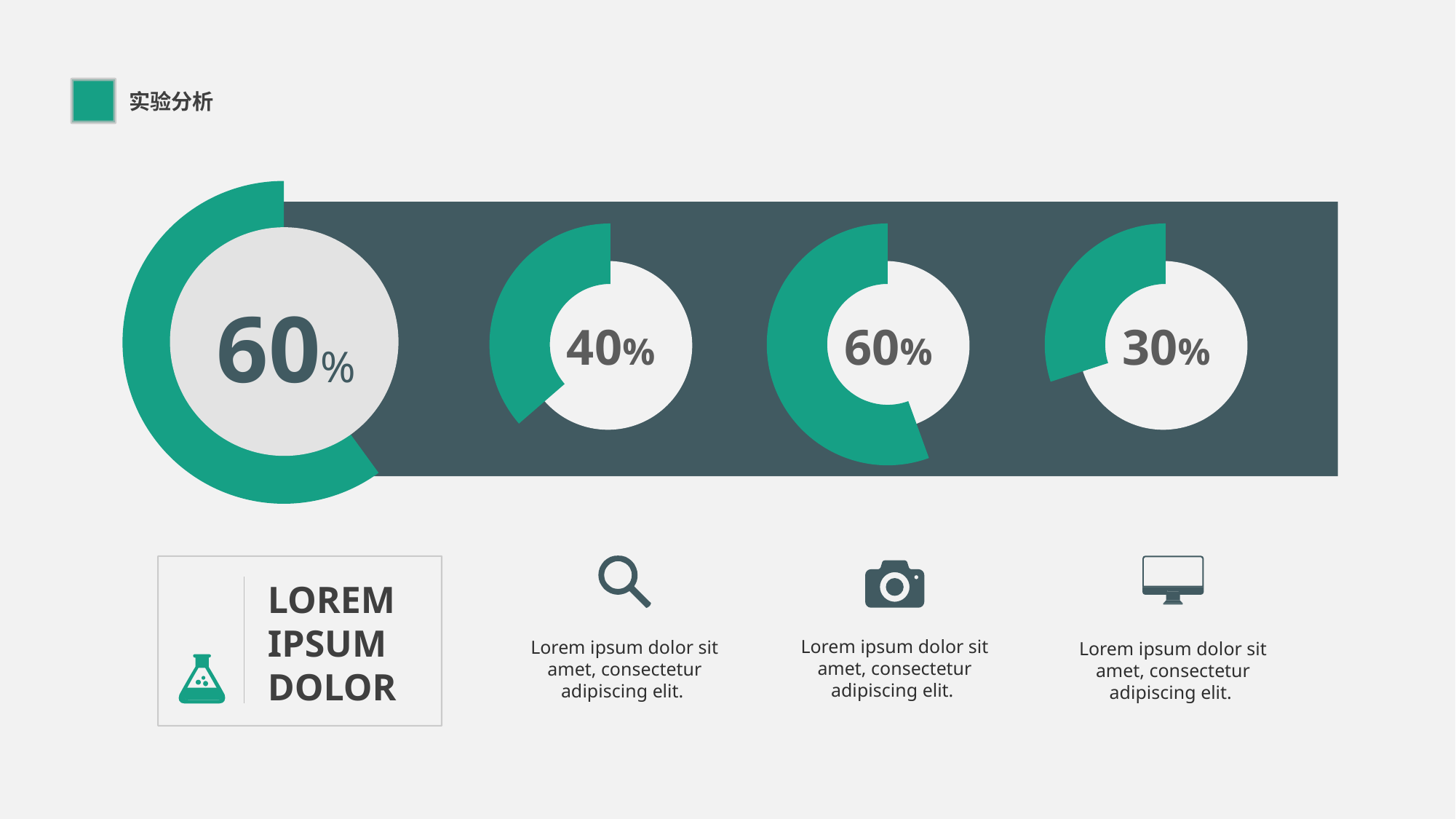
How many donut charts are shown on the slide? 4 What percentage is shown in the third donut chart from the left? 60% What is the difference between the leftmost donut chart's value and the rightmost donut chart's value? 30% What kind of chart is used to display the percentages on this slide? Donut chart What is the highest percentage shown across the donut charts? 60% Which donut chart shows the lowest percentage? The rightmost one (30%) What percentage is shown in the second donut chart from the left? 40% What is the difference between the second donut chart's value and the rightmost donut chart's value? 10% What percentage is shown in the leftmost (largest) donut chart? 60% What percentage is shown in the rightmost donut chart? 30% What colour is the filled portion of each donut chart? Green Which is larger: the value in the second donut chart from the left or the value in the rightmost donut chart? The second from the left (40%)